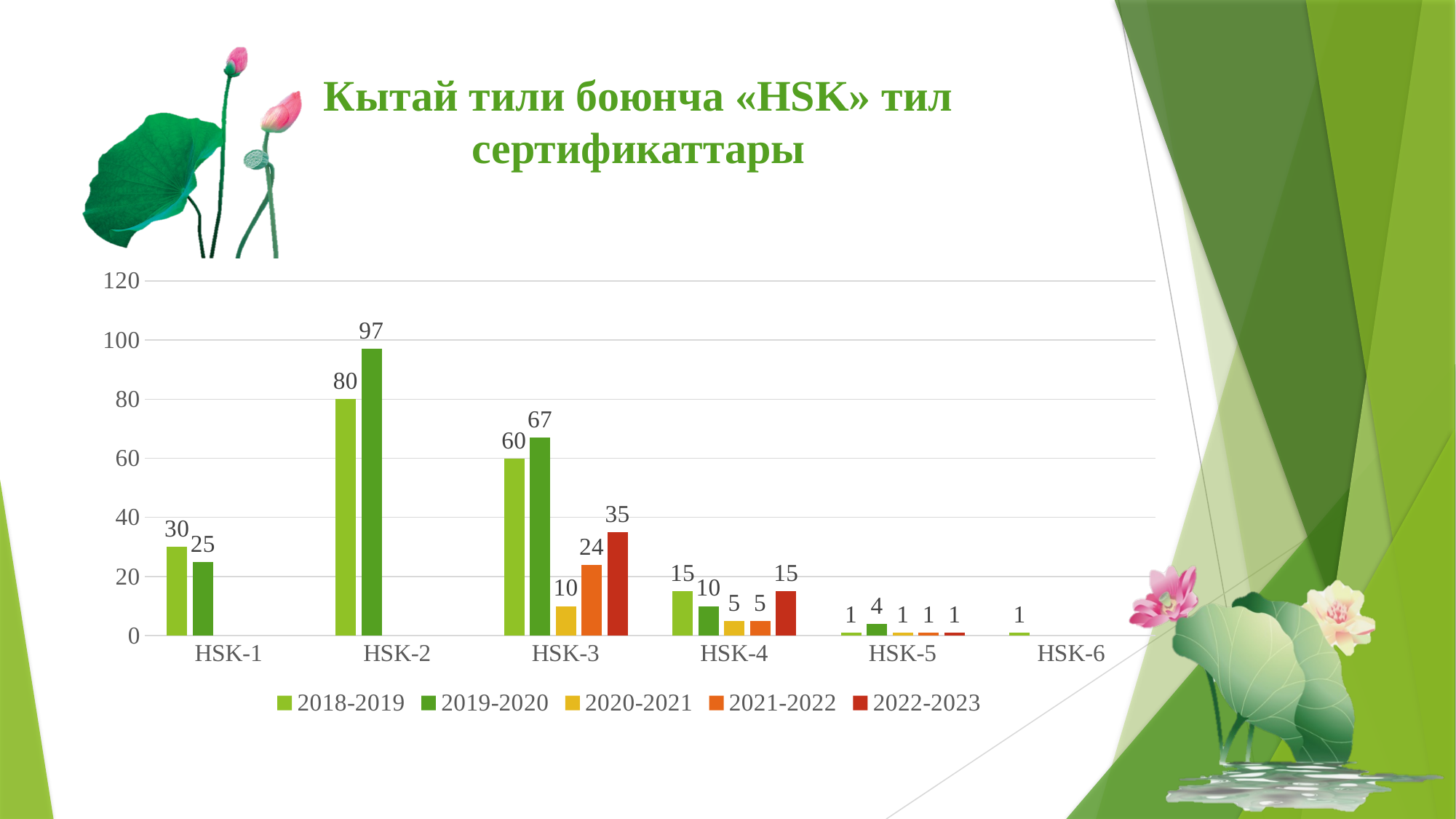
What is the difference between the 2019-2020 and 2018-2019 values for HSK-2? 17 Which HSK level has the lowest value in the 2018-2019 series? HSK-5 and HSK-6 (both 1) What is the value for HSK-1 in the 2018-2019 series? 30 How many HSK level categories are shown on the x axis? 6 What is the value for HSK-2 in the 2019-2020 series? 97 What is the title of the chart on the slide? Кытай тили боюнча «HSK» тил сертификаттары Which is larger for HSK-3: the 2021-2022 value or the 2020-2021 value? 2021-2022 Is the value for HSK-2 in the 2018-2019 series greater or less than 60? greater What is the value for HSK-3 in the 2022-2023 series? 35 How many series does the legend list? 5 What type of chart is shown on the slide? bar chart Which HSK level has the highest value in the 2019-2020 series? HSK-2